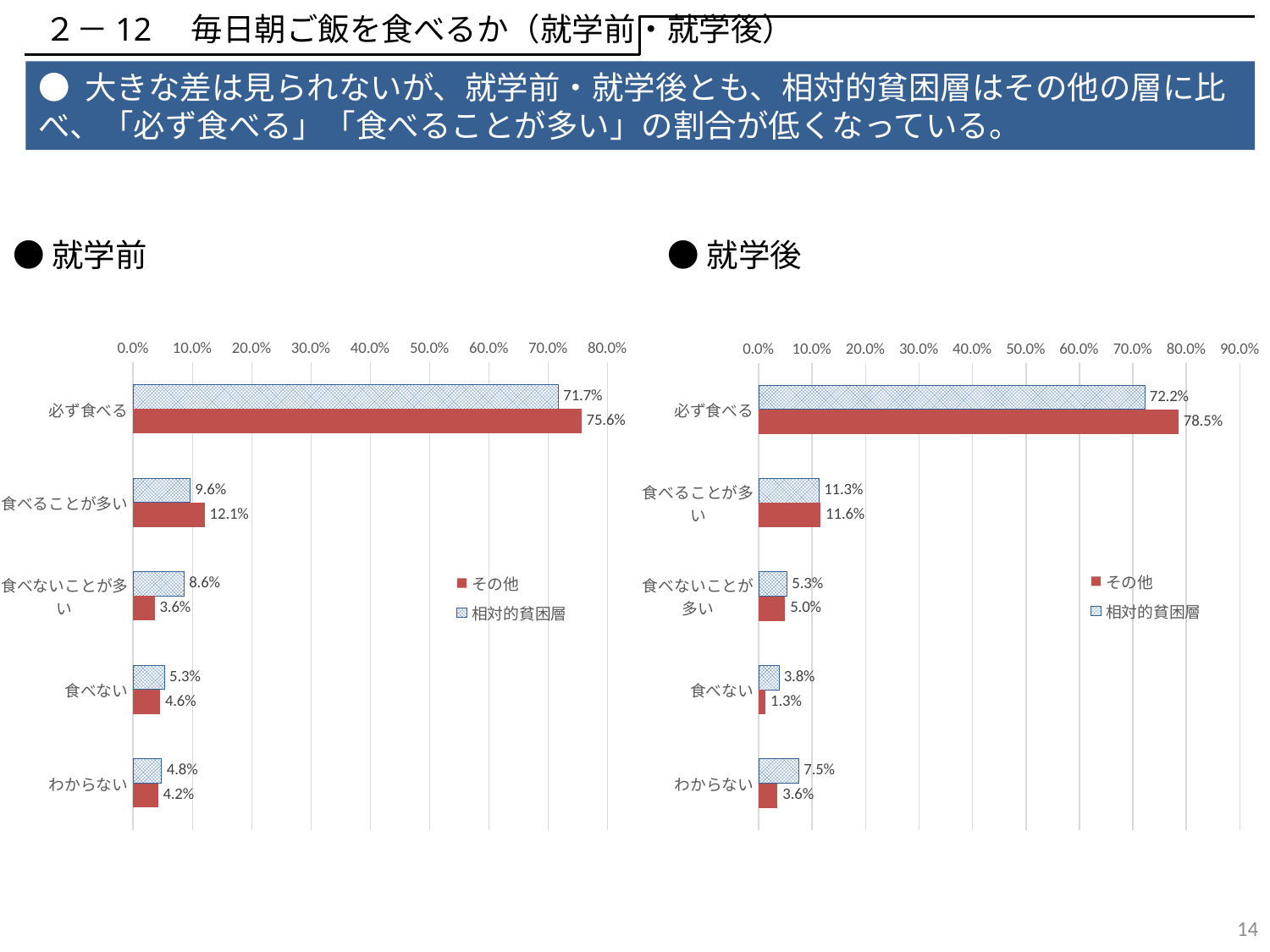
In the 就学後 chart, what is the value for 相対的貧困層 in the わからない category? 7.5% In the 就学後 chart, what is the value for その他 in the 必ず食べる category? 78.5% How many categories are shown in the 就学後 chart? 5 In the 就学前 chart, which category has the highest value for その他? 必ず食べる In the 就学前 chart, what is the value for その他 in the 食べることが多い category? 12.1% In the 就学後 chart, which category has the lowest value for その他? 食べない In the 就学前 chart, what is the value for 相対的貧困層 in the 必ず食べる category? 71.7% What kind of chart is the 就学後 chart? Bar chart In the 就学前 chart, which is larger in the 食べないことが多い category, その他 or 相対的貧困層? 相対的貧困層 How many series does the legend of the 就学前 chart list? 2 In the 就学後 chart, what is the difference between その他 and 相対的貧困層 in the 必ず食べる category? 6.3% In the 就学前 chart, is the value for その他 in the 必ず食べる category greater or less than 70.0%? greater